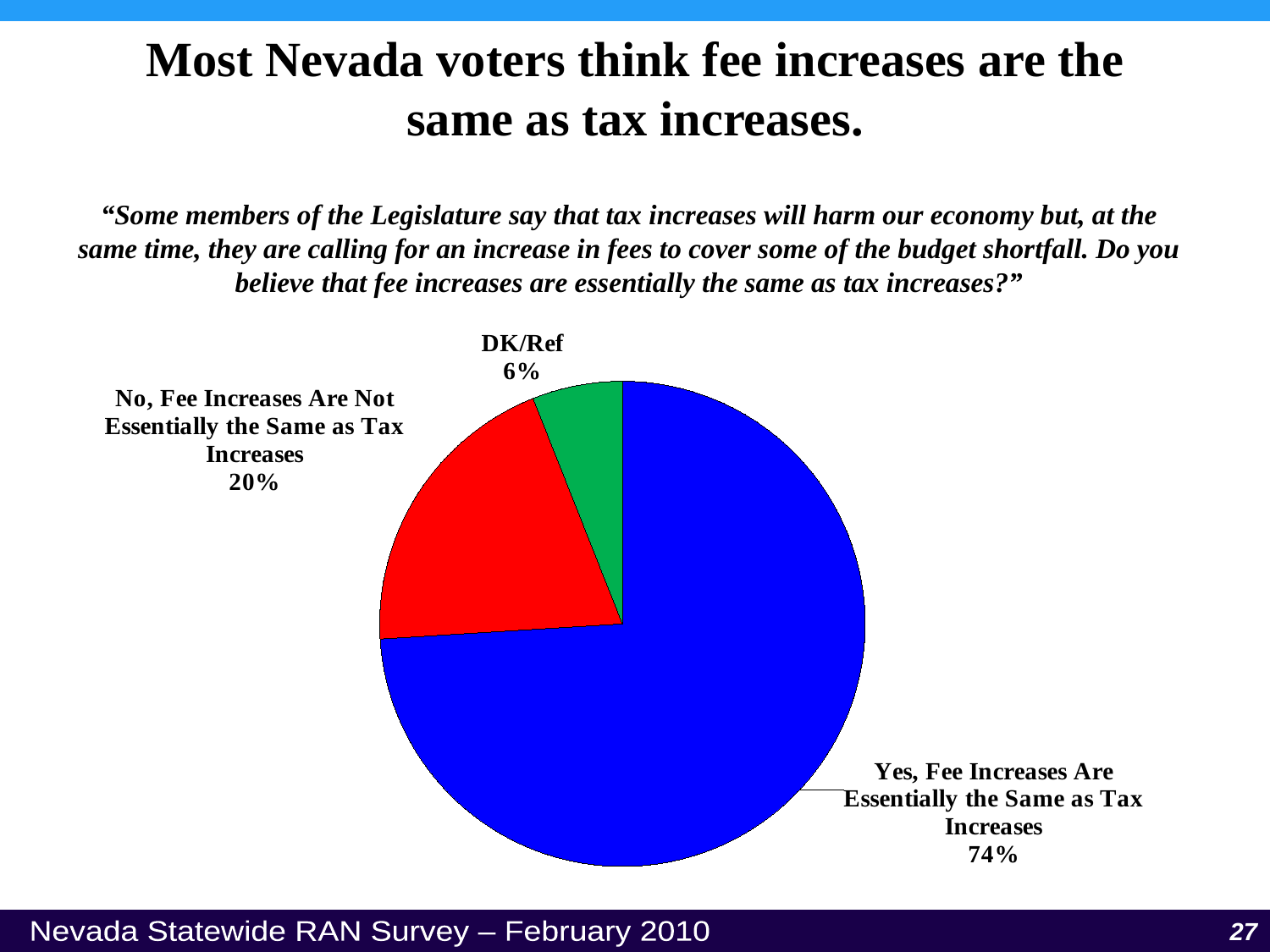
What colour is the slice for Yes, fee increases are essentially the same as tax increases? blue Which response has the largest share of the pie? Yes, Fee Increases Are Essentially the Same as Tax Increases What colour is the DK/Ref slice? green What percentage of respondents answered DK/Ref? 6% Which is larger, the share for No or the share for DK/Ref? No What is the difference in percentage points between the No response and DK/Ref? 14 What is the difference in percentage points between the Yes and No responses? 54 What kind of chart is shown on the slide? pie chart Which response has the smallest share of the pie? DK/Ref What percentage of respondents said No, fee increases are not essentially the same as tax increases? 20% How many slices does the pie chart have? 3 What percentage of respondents said Yes, fee increases are essentially the same as tax increases? 74%